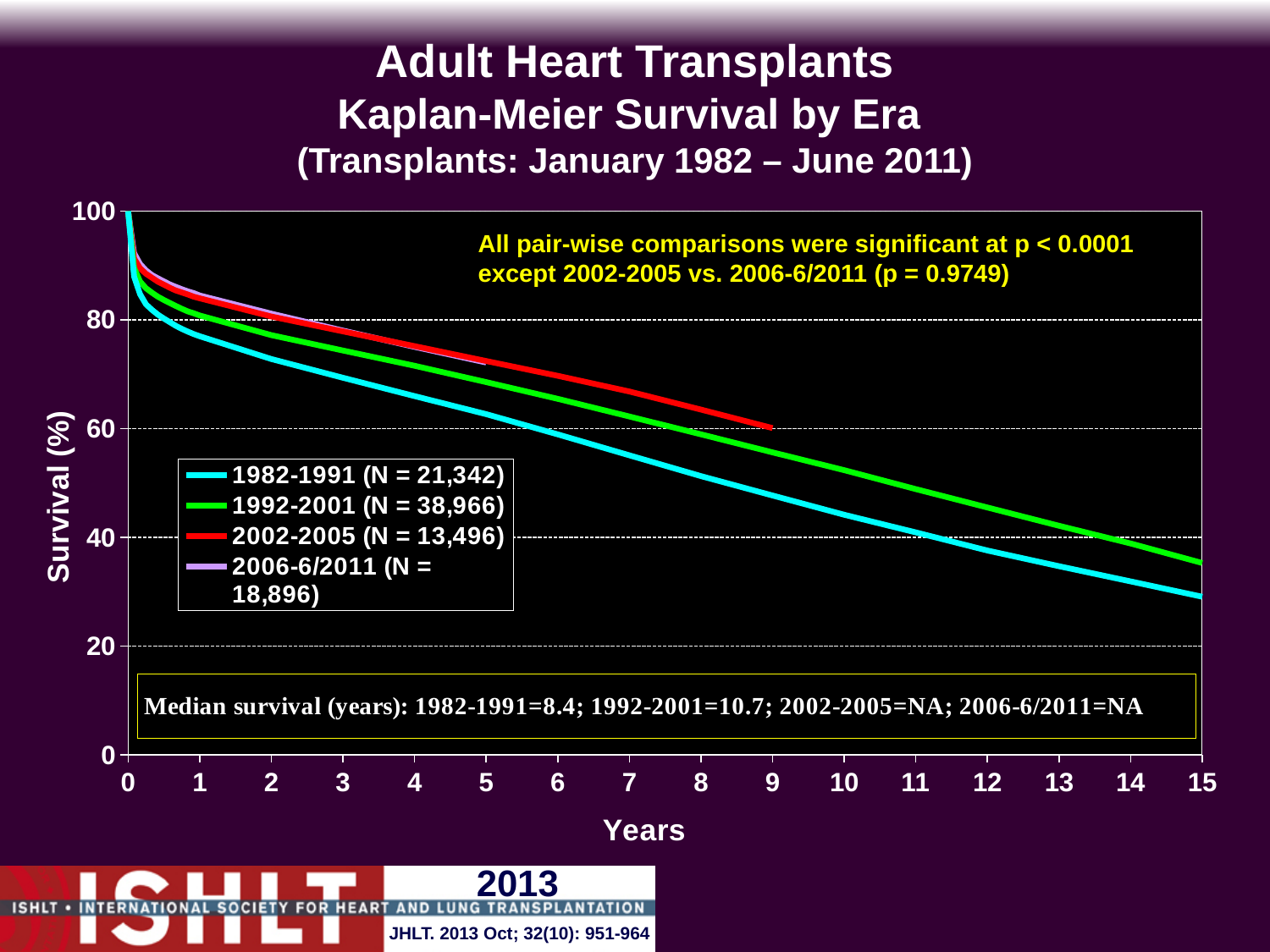
What is the median survival in years for the 1992-2001 era? 10.7 Is the survival for the 1982-1991 era at year 15 greater or less than 40? less According to the legend, what is N for the 1992-2001 era? 38,966 How many series (eras) does the legend list? 4 Which era has the largest N in the legend? 1992-2001 Do the survival curves rise or fall as the number of years increases? Fall At year 10, which era has higher survival, 1982-1991 or 1992-2001? 1992-2001 Which era has the lowest survival at year 5? 1982-1991 What is the label of the y axis? Survival (%) What is the difference in N between the 1992-2001 era and the 1982-1991 era? 17,624 What is the median survival in years for the 1982-1991 era? 8.4 What kind of chart is shown on the slide? Line chart